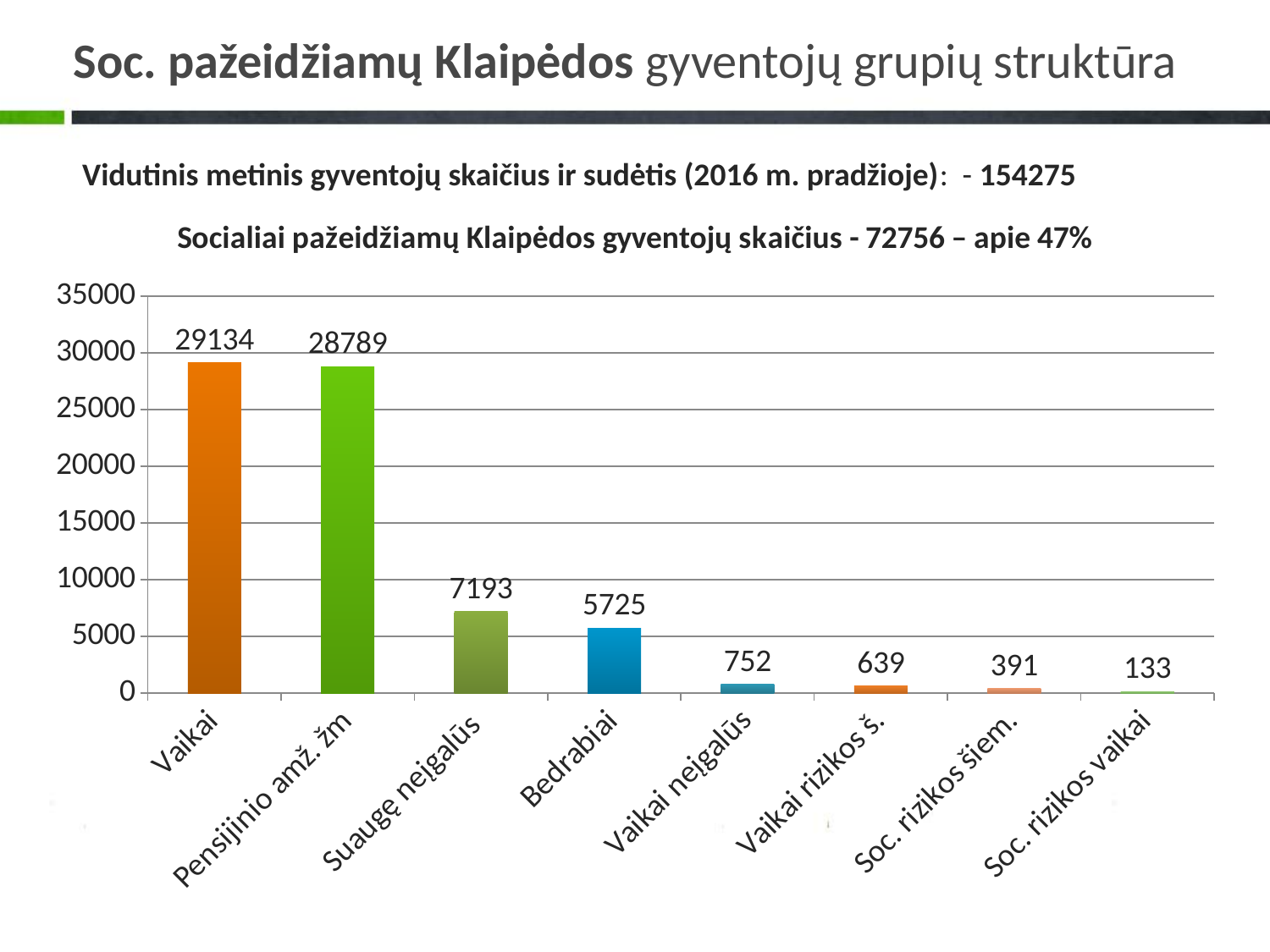
Which category has the highest value? Vaikai What is the difference between the values for Suaugę neįgalūs and Bedrabiai? 1468 What is the value for Vaikai? 29134 What is the difference between the values for Vaikai neįgalūs and Vaikai rizikos š.? 113 What kind of chart is shown on the slide? bar chart How many categories are shown on the x axis? 8 Is the value for Suaugę neįgalūs greater or less than 5000? greater What is the value for Bedrabiai? 5725 Which category has the lowest value? Soc. rizikos vaikai What is the value for Soc. rizikos šiem.? 391 Which is larger, the value for Vaikai or the value for Pensijinio amž. žm? Vaikai What is the value for Pensijinio amž. žm? 28789